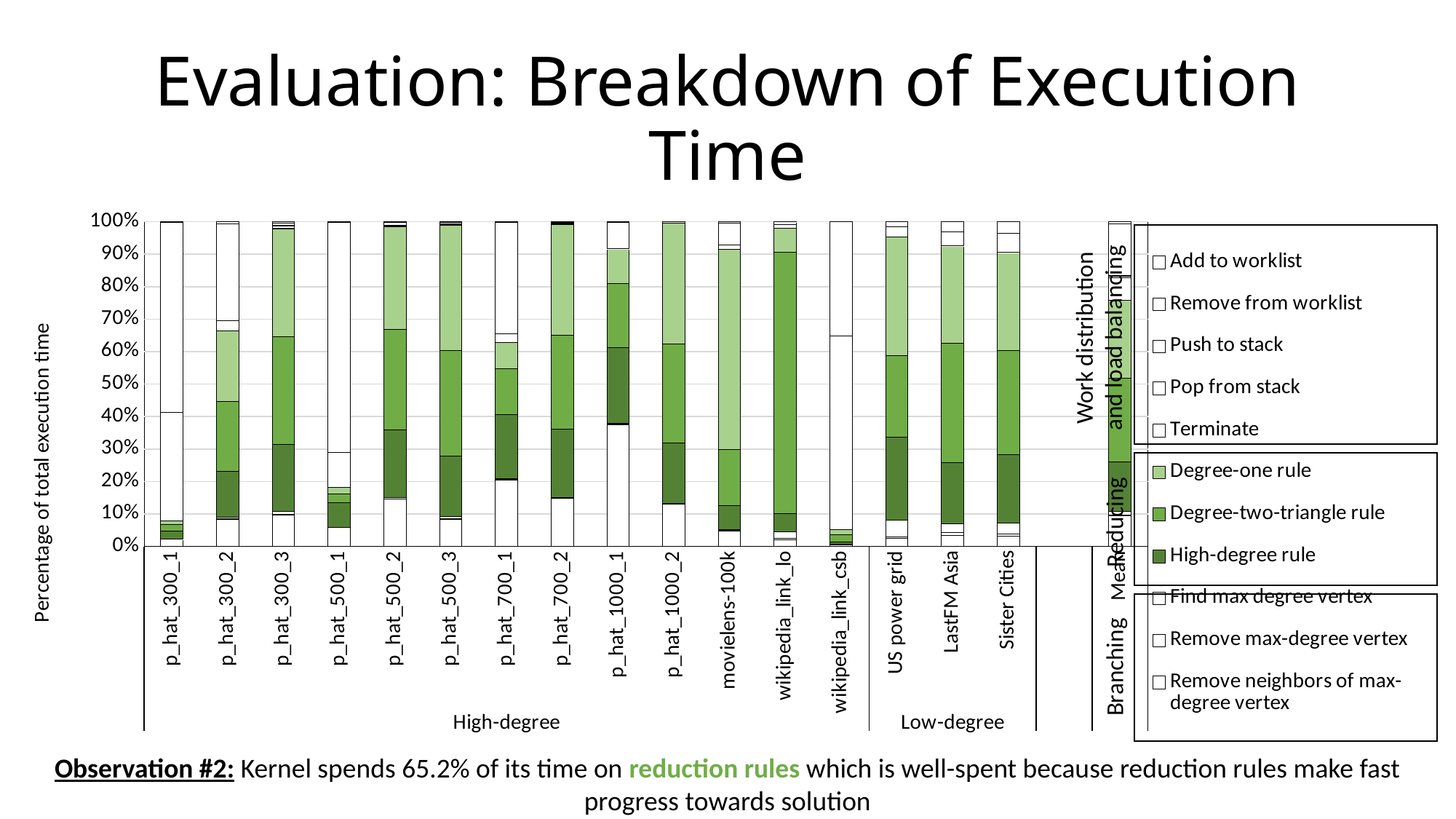
Which bar has a larger green (reduction rule) portion, p_hat_500_1 or p_hat_500_2? p_hat_500_2 How many series does the legend list? 11 Which bar has a larger green (reduction rule) portion, wikipedia_link_lo or wikipedia_link_csb? wikipedia_link_lo What is the label of the y axis? Percentage of total execution time Is the total green (reduction rule) portion of the p_hat_1000_1 bar greater or less than 80%? less How many graphs are in the Low-degree group on the x axis? 3 Is the total green (reduction rule) portion of the p_hat_300_1 bar greater or less than 20%? less What is the title of the chart on the slide? Evaluation: Breakdown of Execution Time How many graphs are in the High-degree group on the x axis? 13 How many bars are plotted in the chart, including the Mean bar? 17 Is the total green (reduction rule) portion of the wikipedia_link_csb bar greater or less than 10%? less What kind of chart is shown on the slide? Stacked bar chart